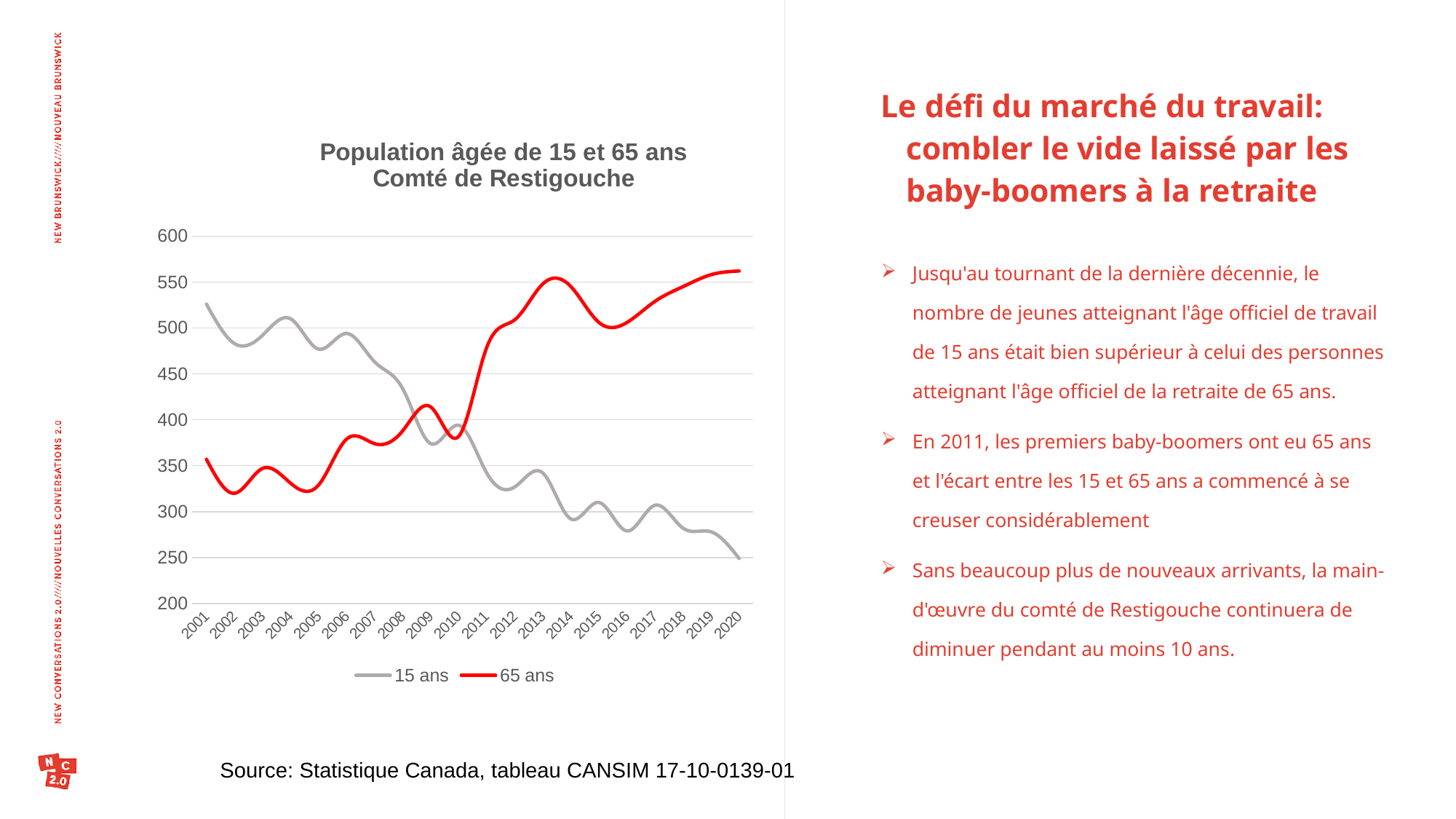
Is the value for 65 ans in 2020 greater or less than 550? greater Is the value for 65 ans in 2002 greater or less than 350? less In 2001, which series has the larger value, 15 ans or 65 ans? 15 ans What is the title of the chart? Population âgée de 15 et 65 ans Comté de Restigouche How many series does the legend list? 2 Is the value for 15 ans in 2001 greater or less than 500? greater Does the 15 ans series rise or fall overall from 2001 to 2020? fall How many years are shown on the x axis? 20 What kind of chart is shown on the slide? line chart In 2020, which series has the larger value, 15 ans or 65 ans? 65 ans Does the 65 ans series rise or fall overall from 2001 to 2020? rise